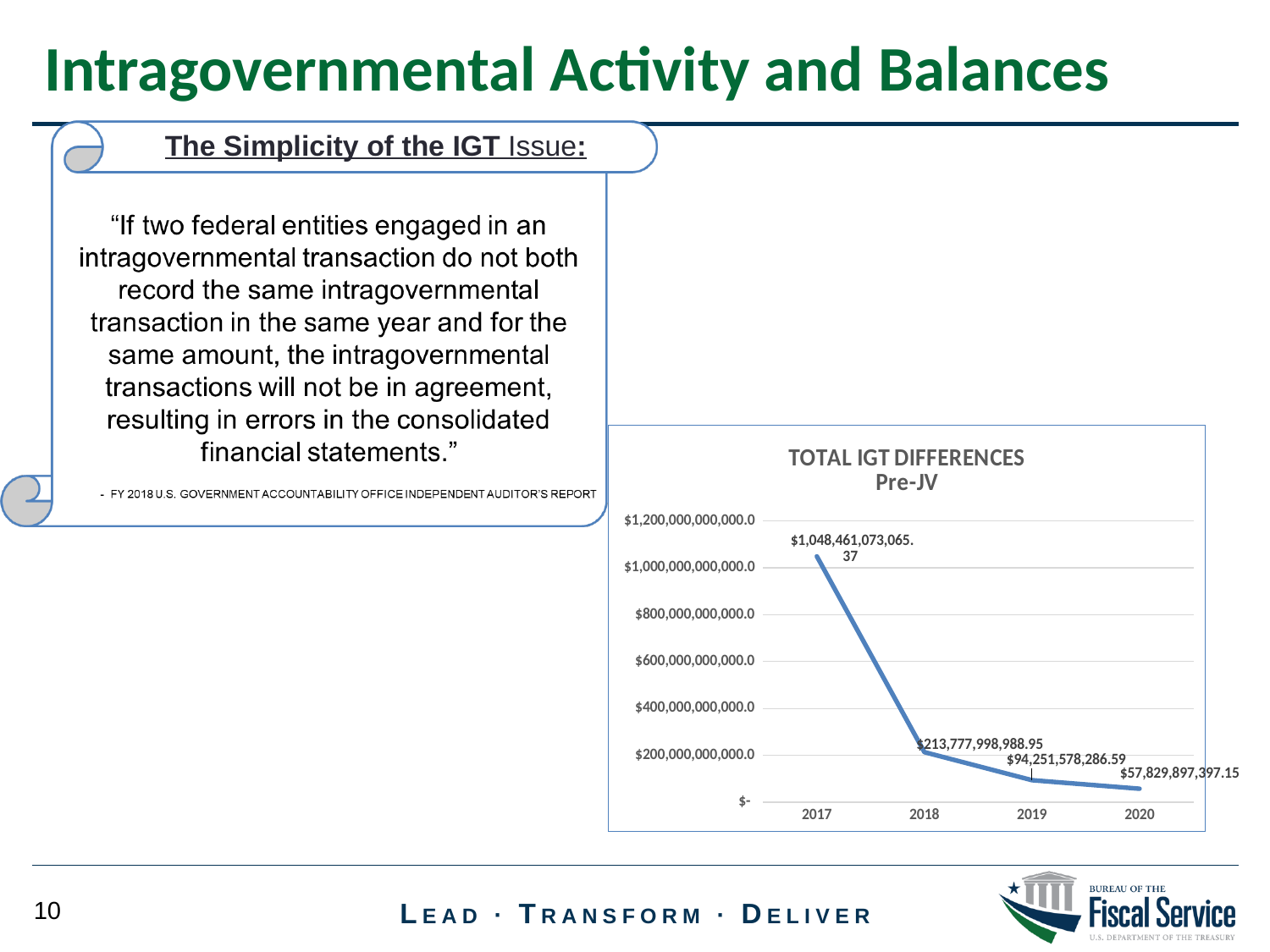
How many years are plotted on the x axis of the chart? 4 What is the value for 2017 in the TOTAL IGT DIFFERENCES Pre-JV chart? $1,048,461,073,065.37 Is the value for 2017 greater or less than $1,000,000,000,000.0? greater Which year has the lowest total IGT differences? 2020 What type of chart is shown on the slide? line chart Which year has the highest total IGT differences? 2017 What is the value for 2020 in the TOTAL IGT DIFFERENCES Pre-JV chart? $57,829,897,397.15 What is the difference between the 2019 and 2020 values? $36,421,680,889.44 Do the total IGT differences rise or fall from 2017 to 2020? fall What is the value for 2019 in the TOTAL IGT DIFFERENCES Pre-JV chart? $94,251,578,286.59 What is the value for 2018 in the TOTAL IGT DIFFERENCES Pre-JV chart? $213,777,998,988.95 What is the title of the chart? TOTAL IGT DIFFERENCES Pre-JV